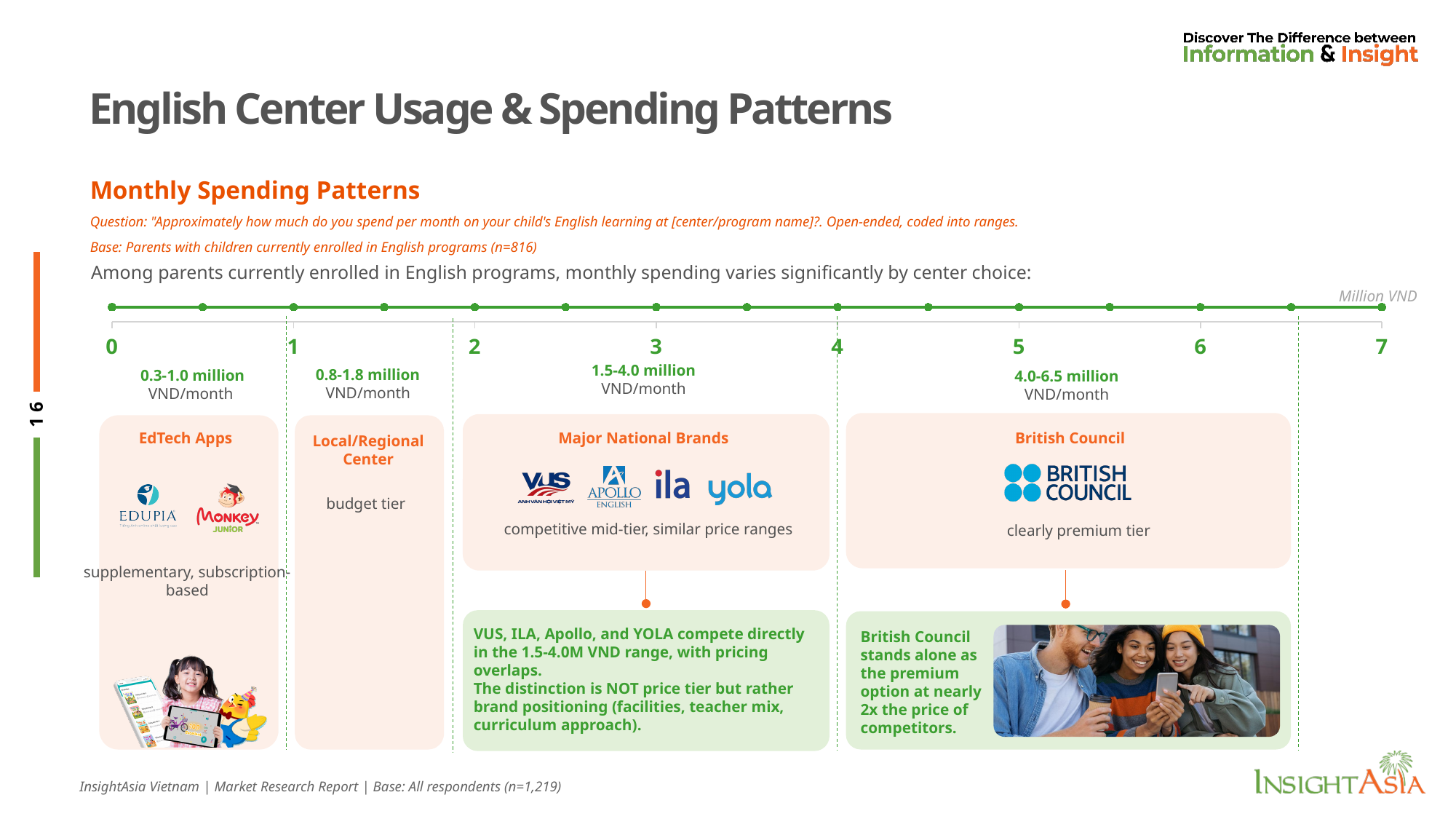
What is the monthly spending range shown for Local/Regional Center? 0.8-1.8 million VND/month What is the monthly spending range shown for EdTech Apps? 0.3-1.0 million VND/month Is the upper bound of the British Council spending range greater or less than 6 million VND? greater What is the monthly spending range shown for Major National Brands? 1.5-4.0 million VND/month What unit is shown at the right end of the axis? Million VND What is the maximum value labelled on the axis? 7 Which has a higher upper spending bound: Major National Brands or Local/Regional Center? Major National Brands What is the monthly spending range shown for British Council? 4.0-6.5 million VND/month How many spending categories (tiers) are shown along the axis? 4 Which category has the lowest monthly spending range on the chart? EdTech Apps Which category has the highest monthly spending range on the chart? British Council What is the difference between the upper bound of the British Council range and the upper bound of the Major National Brands range? 2.5 million VND/month